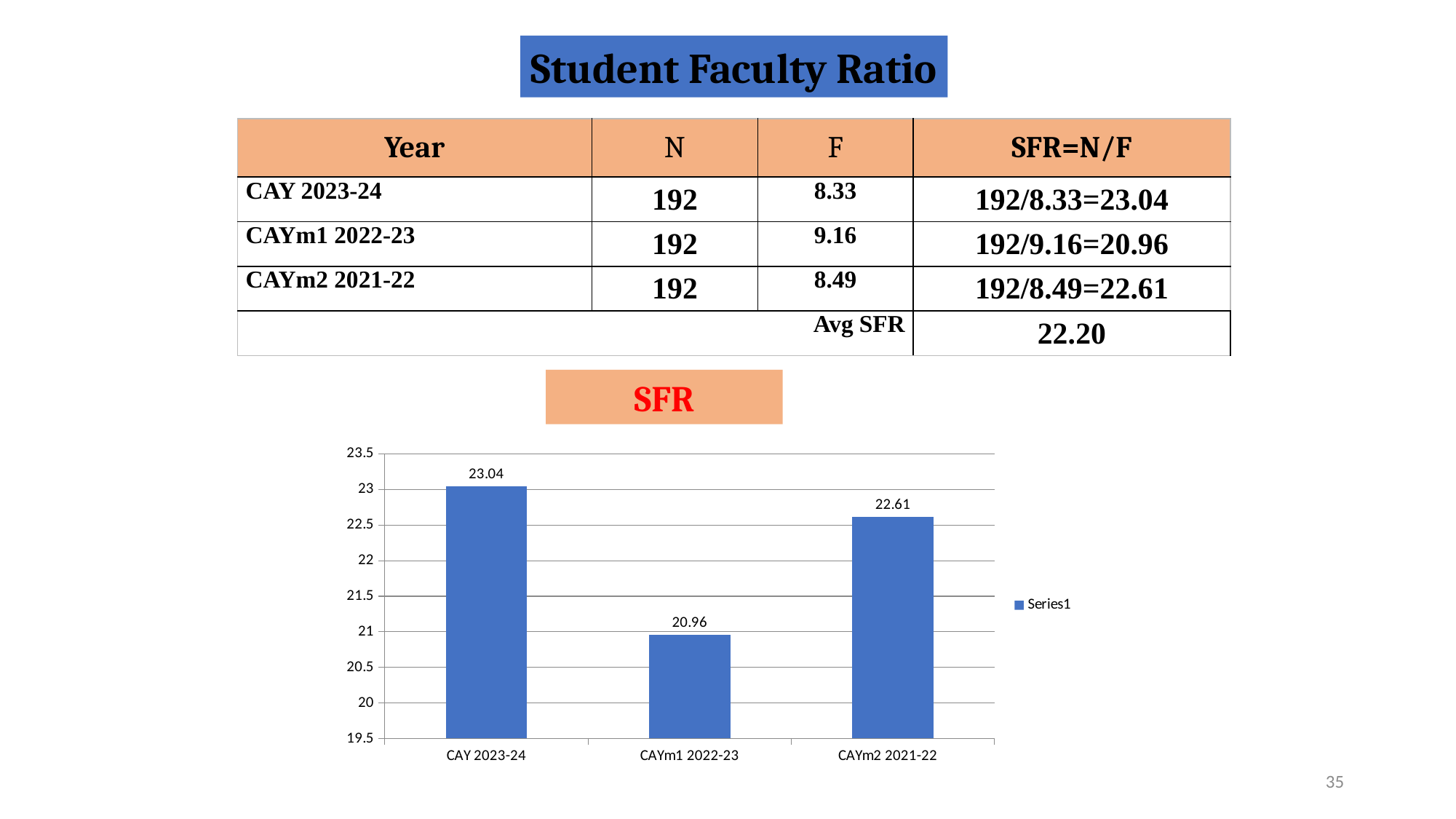
Which year has the lowest SFR in the chart? CAYm1 2022-23 Is the SFR value for CAYm1 2022-23 greater or less than 21? less Which year has the highest SFR in the chart? CAY 2023-24 What is the difference between the SFR for CAYm2 2021-22 and CAYm1 2022-23? 1.65 What is the SFR value for CAYm1 2022-23 in the chart? 20.96 How many years are shown in the SFR chart? 3 What is the difference between the SFR for CAY 2023-24 and CAYm1 2022-23? 2.08 Which is larger, the SFR for CAY 2023-24 or for CAYm2 2021-22? CAY 2023-24 What type of chart is used to show the SFR? bar chart What is the SFR value for CAY 2023-24 in the chart? 23.04 How many series does the chart legend list? 1 What is the SFR value for CAYm2 2021-22 in the chart? 22.61